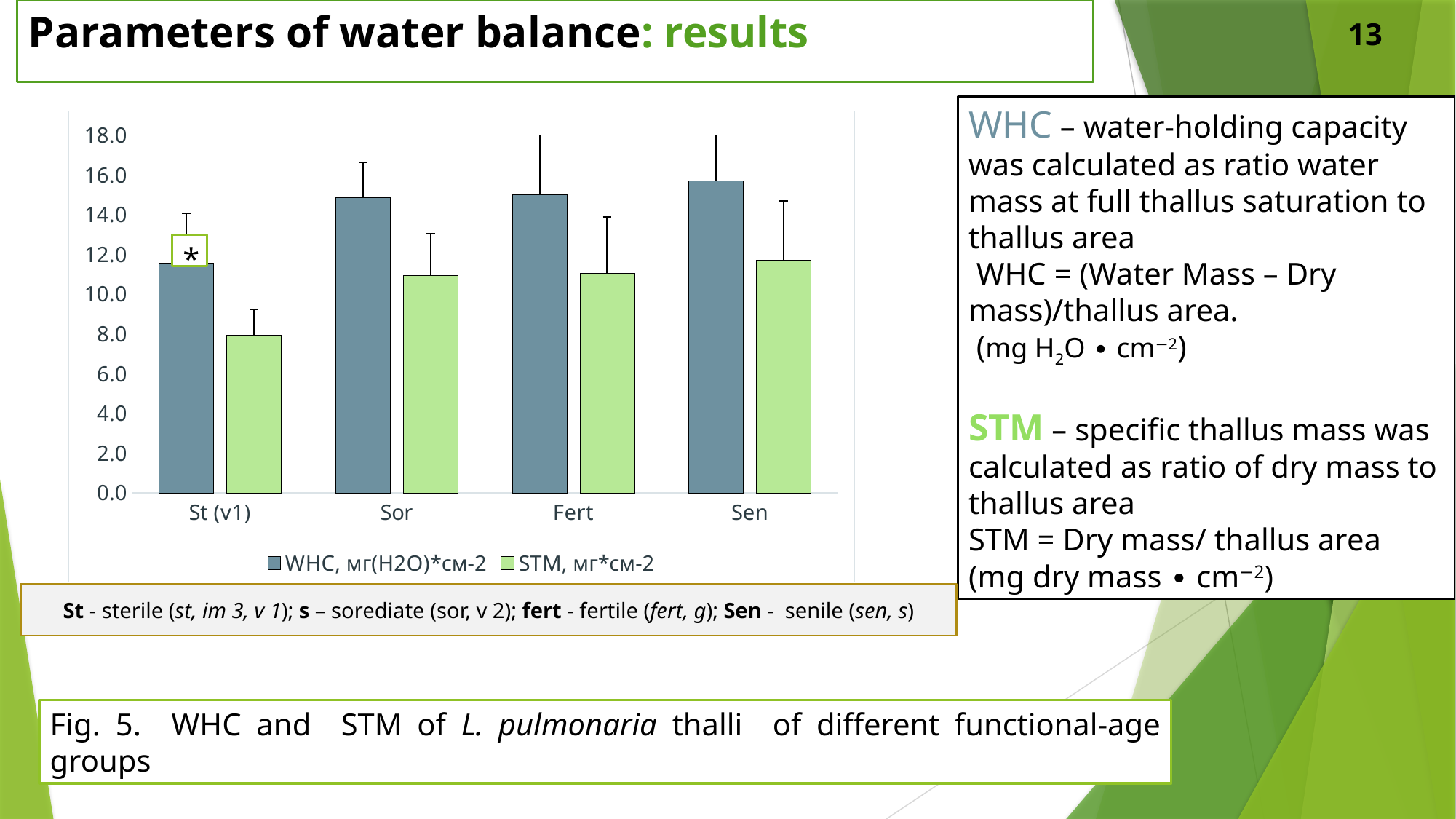
Which category has the lowest WHC value? St (v1) Which category has the lowest STM value? St (v1) Is the WHC value for Sen greater or less than 14.0? greater Is the WHC value for St (v1) greater or less than 10.0? greater Is the STM value for St (v1) greater or less than 10.0? less Which category's WHC bar is marked with an asterisk? St (v1) How many categories are shown on the x axis of the chart? 4 What kind of chart is shown on the slide? bar chart For the Sen category, which is larger: the WHC value or the STM value? WHC How many series does the chart legend list? 2